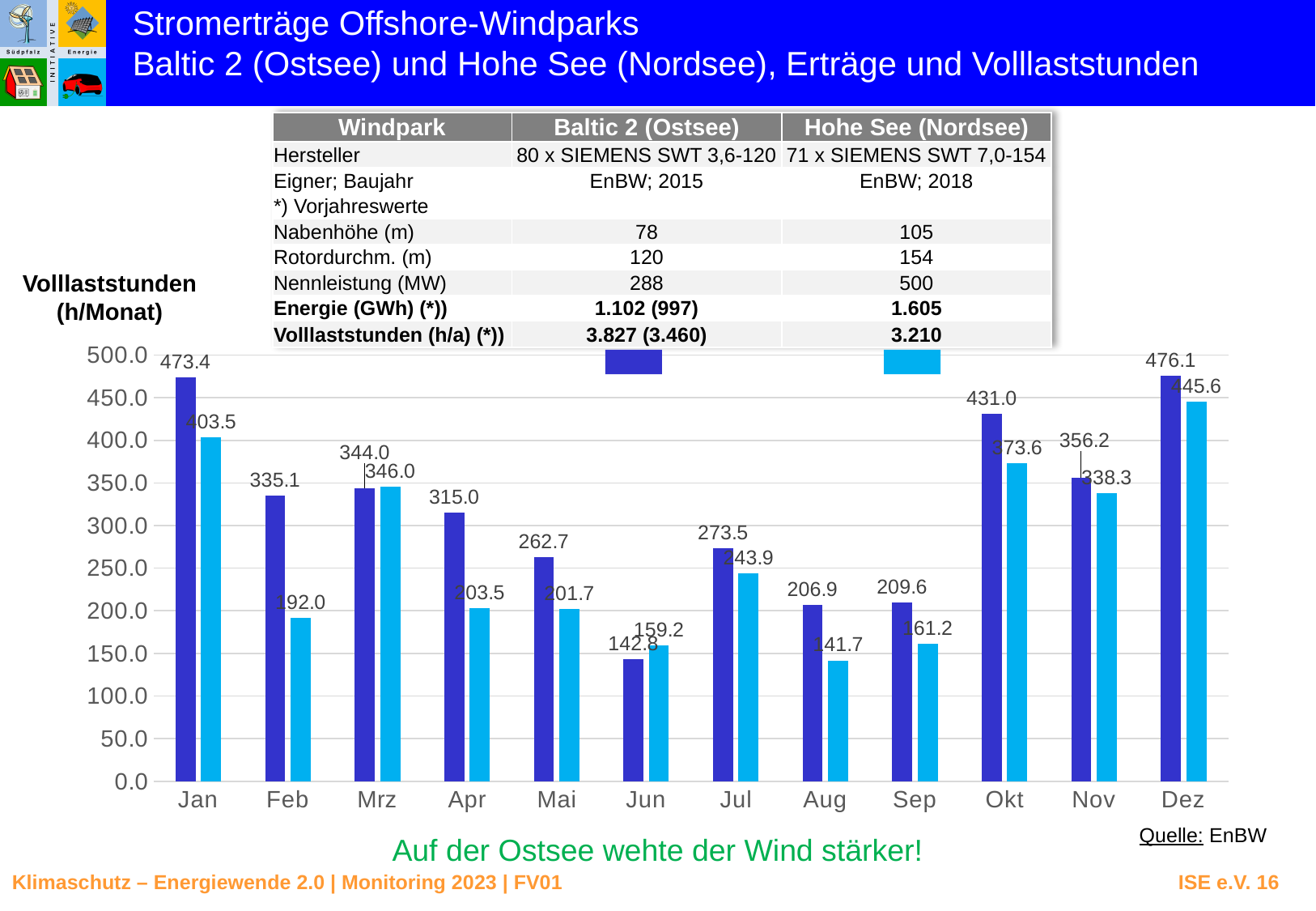
In which month does the dark blue series reach its highest value? Dez Do the dark blue bars rise or fall from Jan to Jun? fall What is the value of the light blue bar for Dez? 445.6 What is the value of the dark blue bar for Jan? 473.4 How many data series does the chart show? 2 Is the value of the dark blue bar for Okt greater or less than 400? greater In Mrz, which bar is larger, the dark blue or the light blue one? light blue What type of chart is shown on the slide? bar chart What is the value of the light blue bar for Jun? 159.2 In which month does the light blue series have its lowest value? Aug How many months are shown on the x axis of the chart? 12 What is the difference between the dark blue and light blue bars in Feb? 143.1